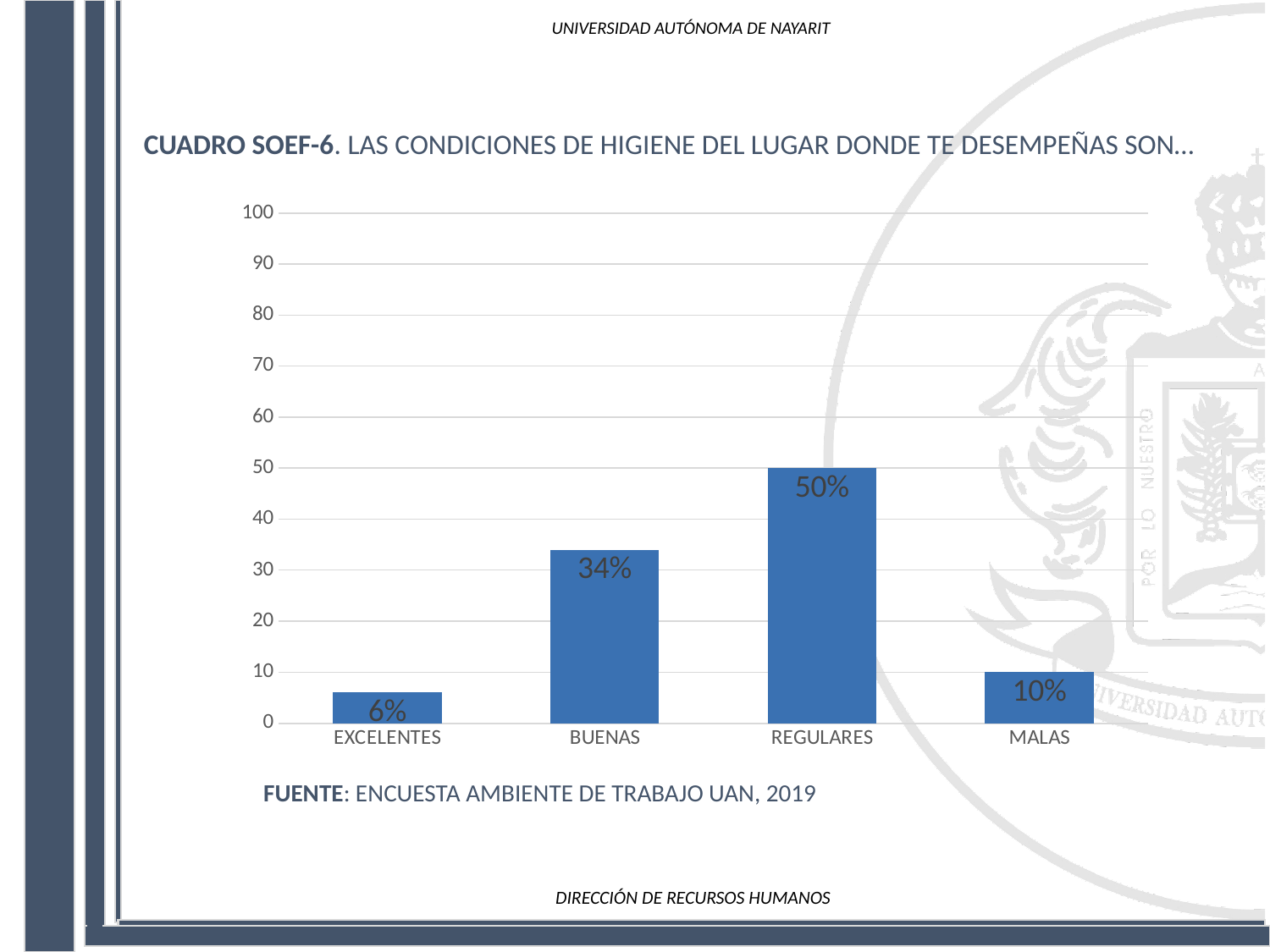
What is the value for MALAS? 10% Which is larger, the value for MALAS or the value for EXCELENTES? MALAS Which category has the highest value? REGULARES What source is cited below the chart? ENCUESTA AMBIENTE DE TRABAJO UAN, 2019 What is the value for REGULARES? 50% What is the difference between the values for REGULARES and BUENAS? 16% What kind of chart is shown on the slide? bar chart What is the value for BUENAS? 34% What is the value for EXCELENTES? 6% Is the value for BUENAS greater or less than 30? greater How many categories are shown on the x axis? 4 Which category has the lowest value? EXCELENTES